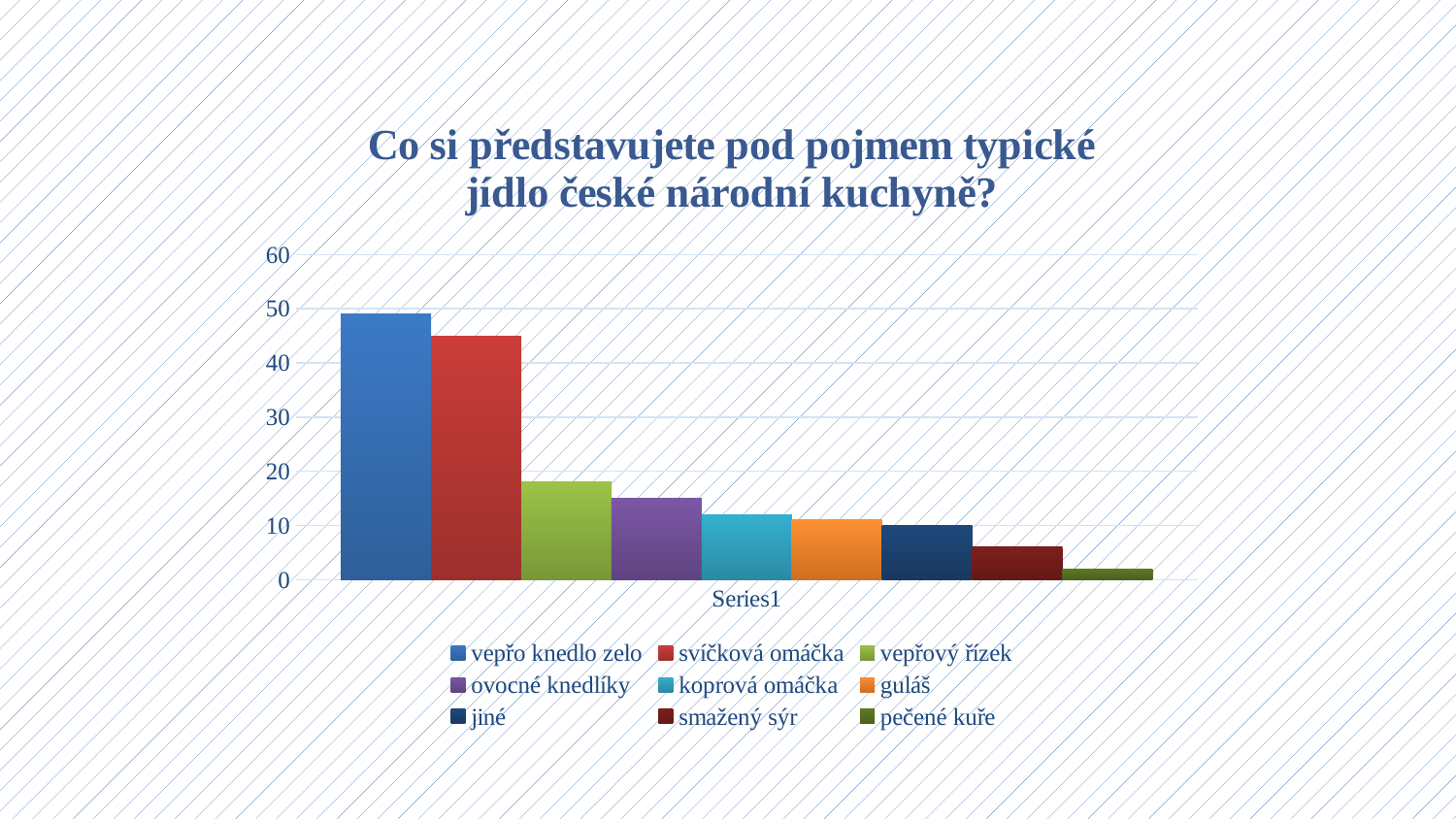
Which legend entry has the shortest bar? pečené kuře What kind of chart is shown on the slide? bar chart Do the bar heights rise or fall from left to right across the chart? fall Which is larger, the bar for smažený sýr or the bar for pečené kuře? smažený sýr What is the title of the chart? Co si představujete pod pojmem typické jídlo české národní kuchyně? Is the value for smažený sýr greater or less than 10? less Is the value for ovocné knedlíky greater or less than 10? greater Which is larger, the bar for vepřo knedlo zelo or the bar for svíčková omáčka? vepřo knedlo zelo Which legend entry has the tallest bar? vepřo knedlo zelo Is the value for vepřo knedlo zelo greater or less than 40? greater How many entries does the legend list? 9